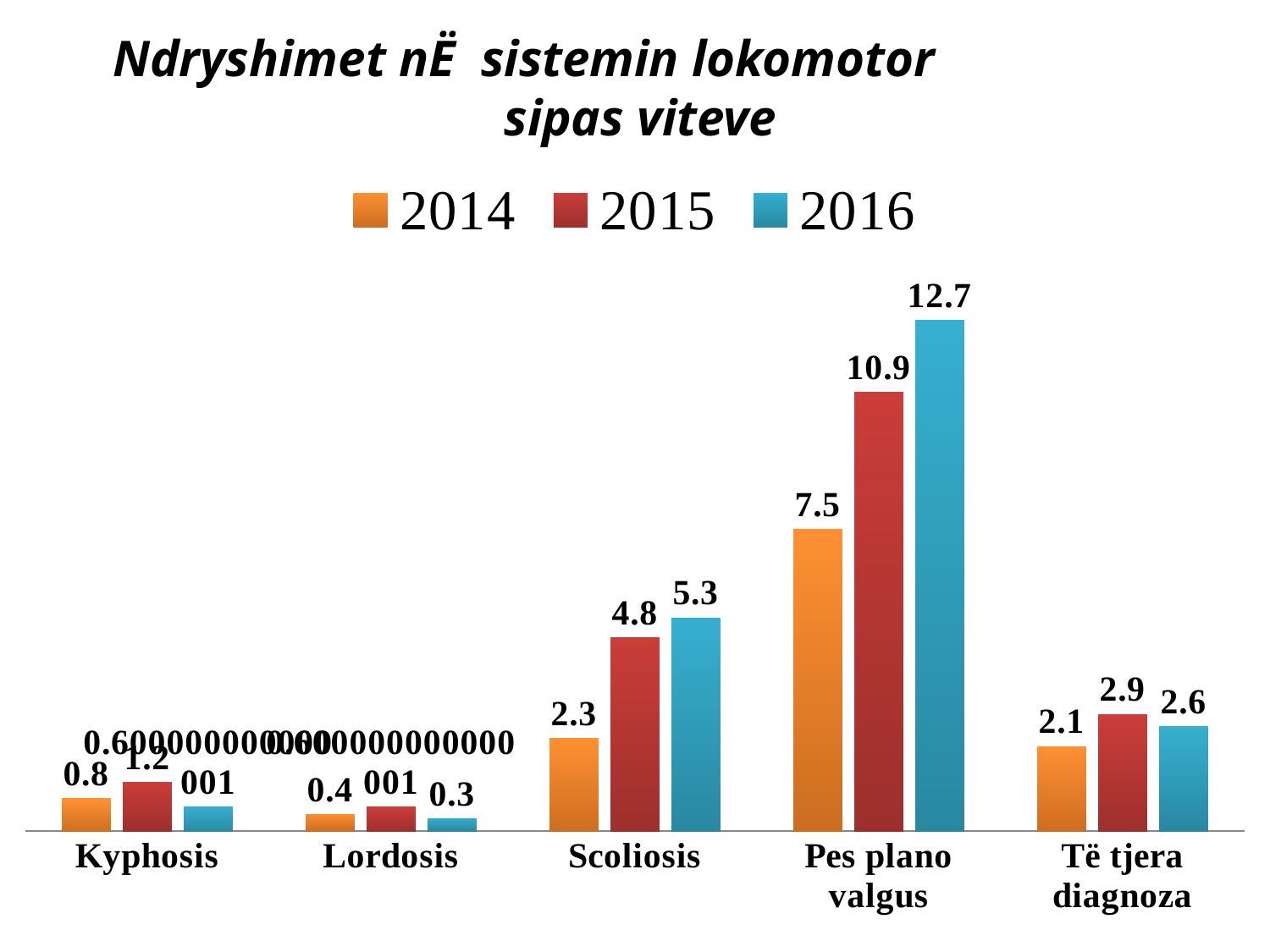
How many series does the legend list? 3 What is the value for Kyphosis in 2015? 1.2 How many categories are shown on the x axis? 5 What is the difference between the 2016 and 2014 values for Pes plano valgus? 5.2 What is the value for Pes plano valgus in 2016? 12.7 What is the value for Të tjera diagnoza in 2014? 2.1 Which category has the lowest value in 2014? Lordosis What is the value for Scoliosis in 2015? 4.8 Which category has the highest value in 2016? Pes plano valgus What is the difference between the 2015 and 2014 values for Scoliosis? 2.5 Which is larger for Të tjera diagnoza, the 2015 value or the 2016 value? 2015 What kind of chart is shown on the slide? bar chart